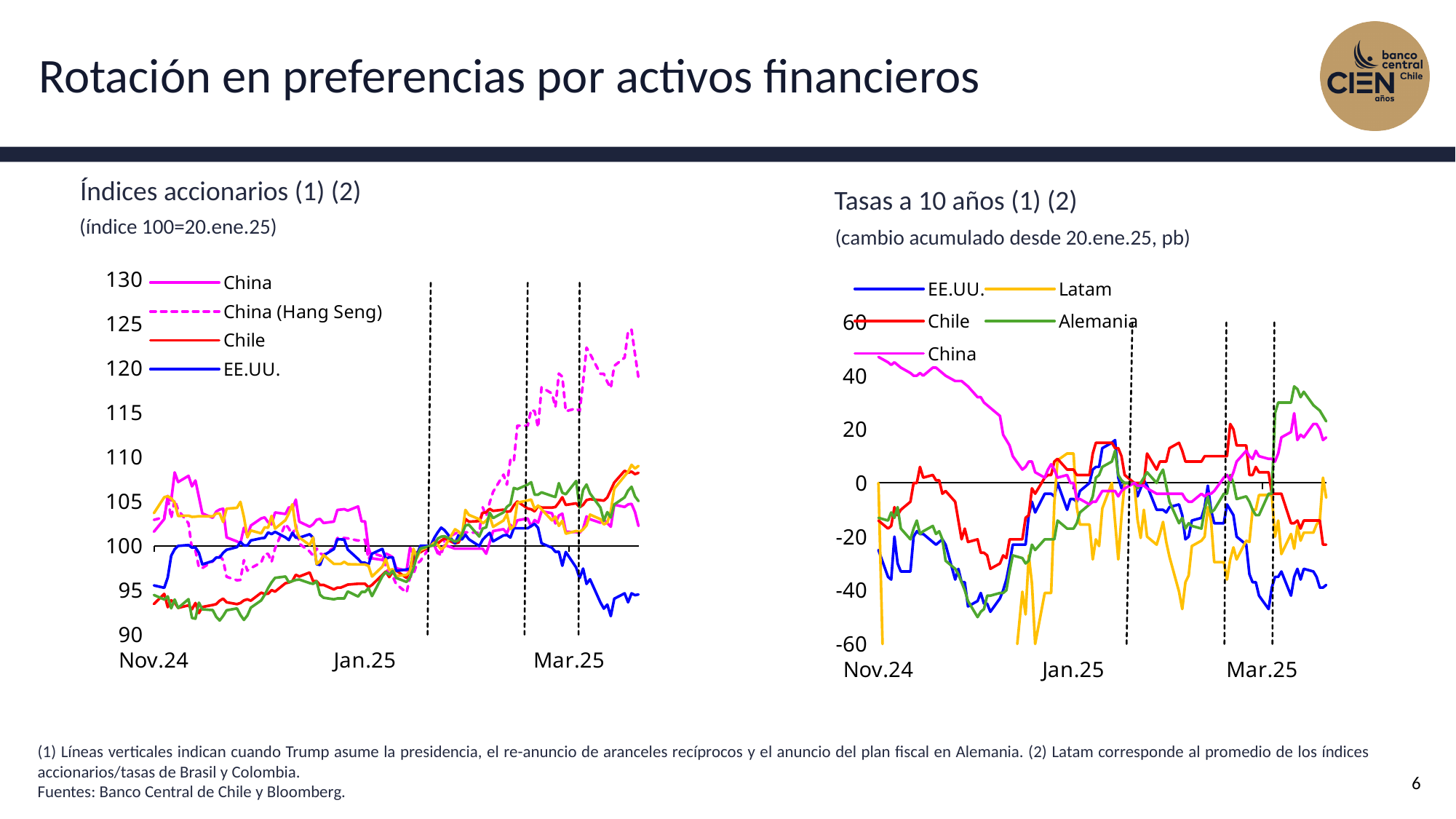
What kind of chart is the 'Índices accionarios (1) (2)' chart? line chart In the 'Índices accionarios (1) (2)' chart, is the value for EE.UU. at the end of the period greater or less than 100? less In the 'Tasas a 10 años (1) (2)' chart, at the start of the period (Nov.24), which is higher: China or EE.UU.? China How many series does the legend of the 'Índices accionarios (1) (2)' chart list? 4 In the 'Índices accionarios (1) (2)' chart, which series is lowest at the end of the period (late Mar.25)? EE.UU. In the 'Tasas a 10 años (1) (2)' chart, is the value for EE.UU. at the end of the period greater or less than -20? less In the 'Índices accionarios (1) (2)' chart, is the value for China (Hang Seng) at the end of the period greater or less than 115? greater In the 'Índices accionarios (1) (2)' chart, which series is highest at the end of the period (late Mar.25)? China (Hang Seng) In the 'Tasas a 10 años (1) (2)' chart, which series is lowest at the end of the period (late Mar.25)? EE.UU. In the 'Índices accionarios (1) (2)' chart, does the EE.UU. series rise or fall between Jan.25 and the end of the period? fall In the 'Tasas a 10 años (1) (2)' chart, does the China series rise or fall from Nov.24 to Jan.25? fall How many series does the legend of the 'Tasas a 10 años (1) (2)' chart list? 5